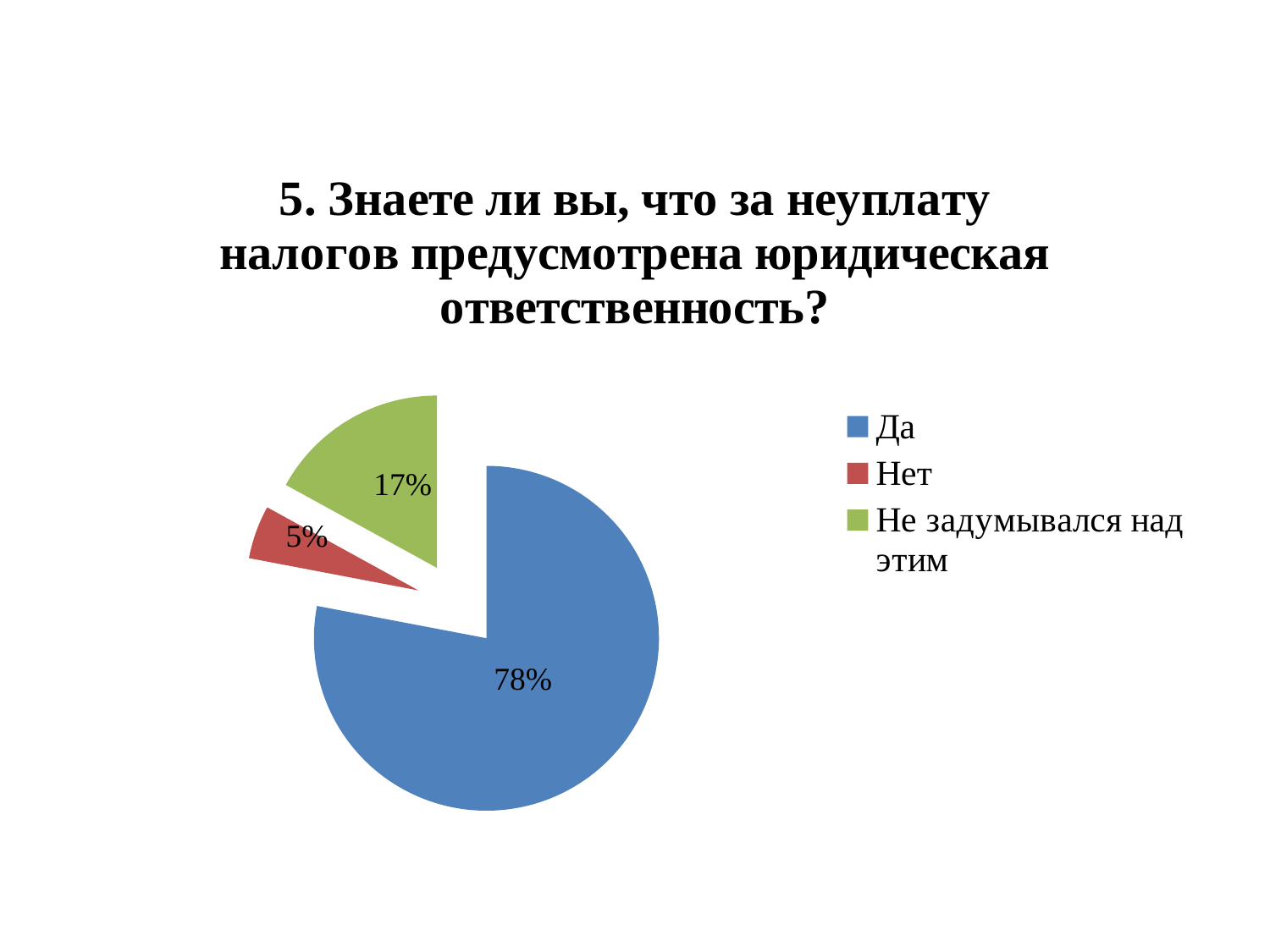
What share of the pie does "Да" have? 78% What is the difference in percentage points between "Да" and "Не задумывался над этим"? 61 What share of the pie does "Не задумывался над этим" have? 17% How many entries does the legend list? 3 Which is larger, the slice for "Нет" or the slice for "Не задумывался над этим"? Не задумывался над этим What is the difference in percentage points between "Не задумывался над этим" and "Нет"? 12 What kind of chart is shown on the slide? pie chart What colour is the slice for "Да"? blue How many slices does the pie chart have? 3 Which category has the smallest slice of the pie? Нет What share of the pie does "Нет" have? 5% Which category has the largest slice of the pie? Да